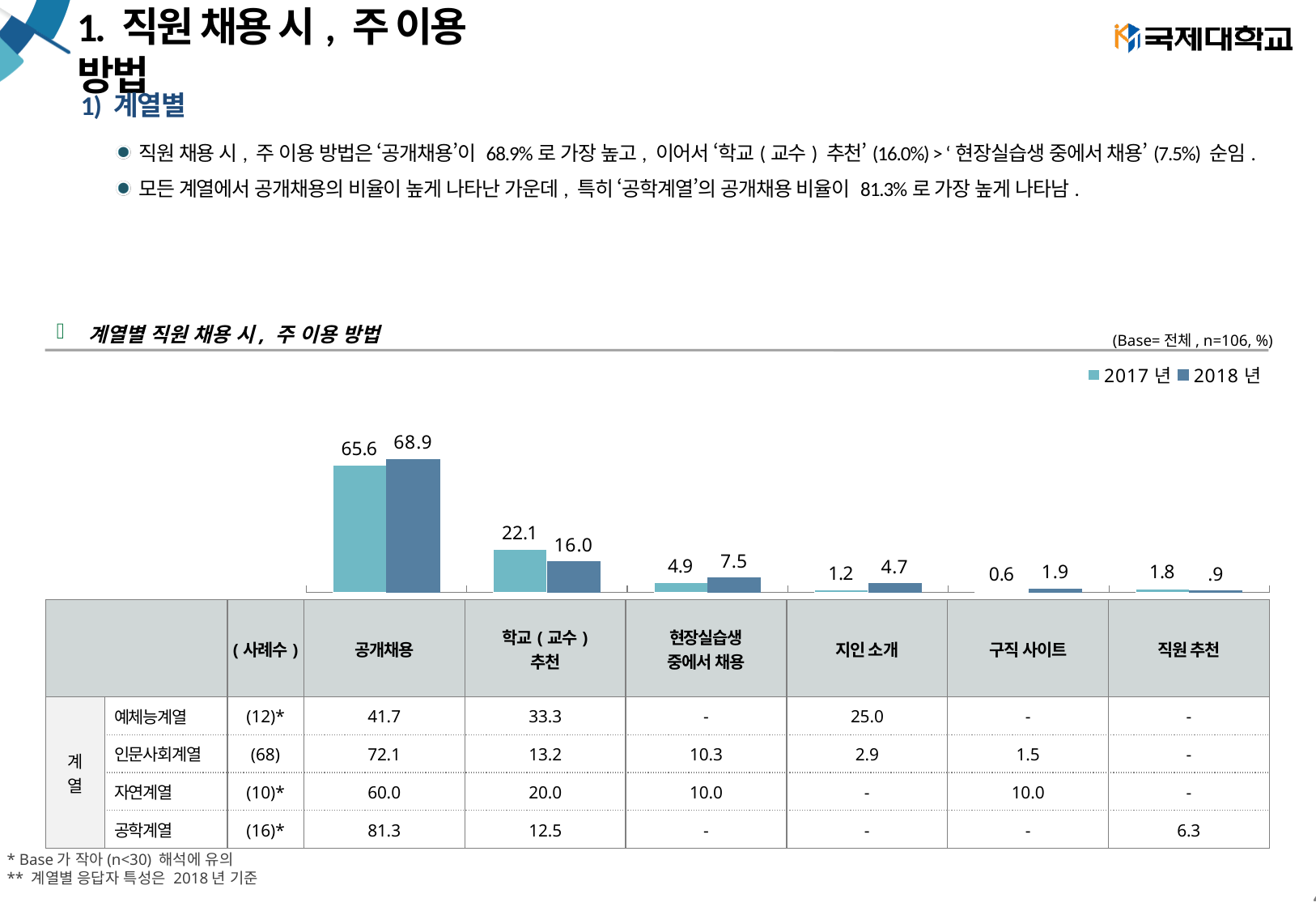
What is the 2018년 value for 현장실습생 중에서 채용? 7.5 What is the 2017년 value for 구직 사이트? 0.6 Which category has the highest 2018년 value? 공개채용 How many series does the chart legend list? 2 Which is larger for 학교(교수) 추천, the 2017년 value or the 2018년 value? 2017년 What is the 2018년 value for 공개채용? 68.9 What kind of chart is shown on the slide? bar chart What is the difference between the 2018년 and 2017년 values for 공개채용? 3.3 How many categories are shown on the chart's x axis? 6 Which category has the lowest 2017년 value? 구직 사이트 What is the difference between the 2017년 and 2018년 values for 지인 소개? 3.5 What is the 2017년 value for 학교(교수) 추천? 22.1